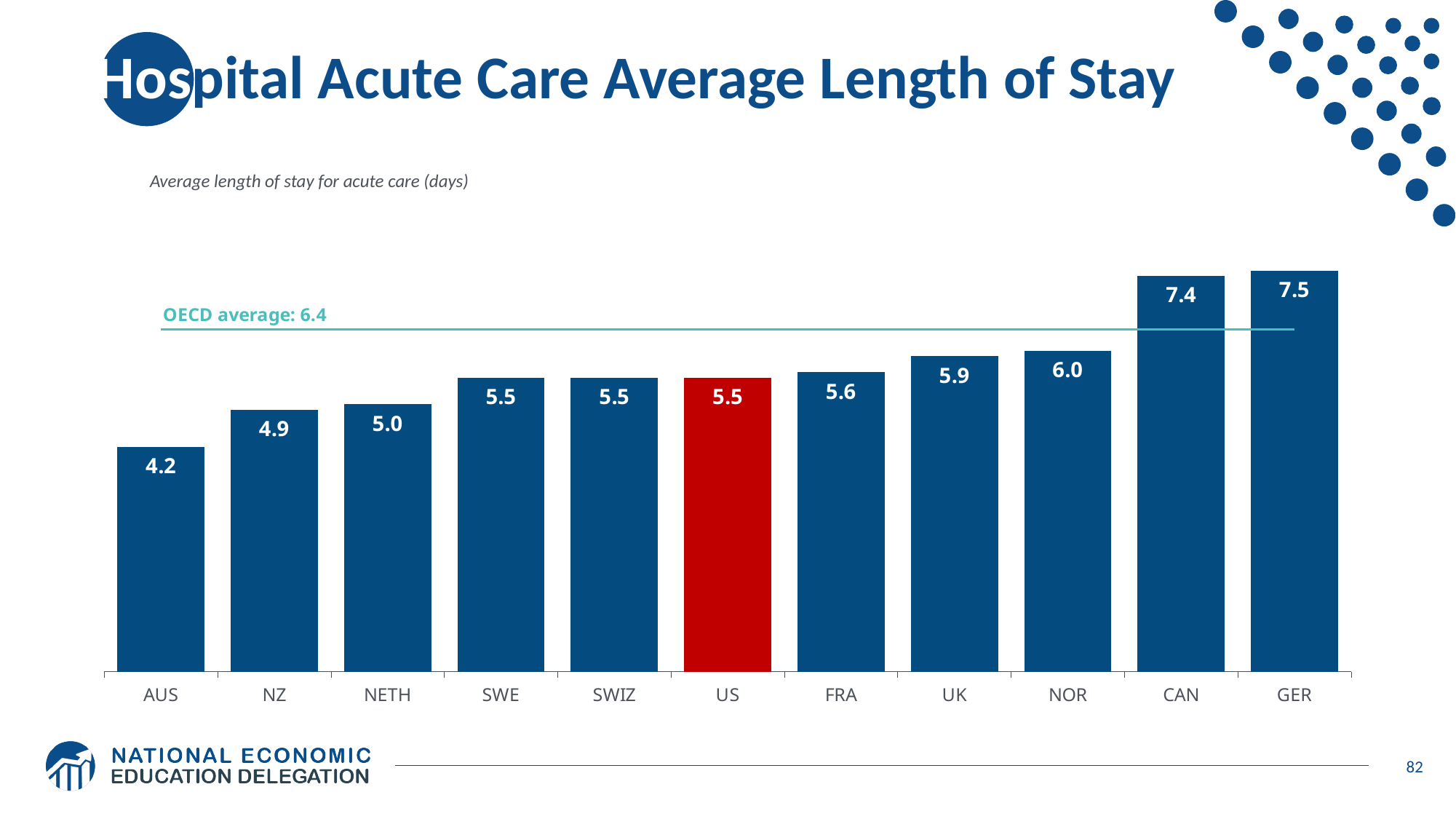
What type of chart is shown on the slide? Bar chart What is the average length of stay for acute care in the US? 5.5 What is the average length of stay for acute care in NOR? 6.0 What is the average length of stay for acute care in AUS? 4.2 How many countries are shown in the chart? 11 Which has a longer average length of stay, UK or NETH? UK Which country has the lowest average length of stay for acute care? AUS What is the OECD average shown on the chart? 6.4 Which country's bar is highlighted in red? US What is the difference in average length of stay between GER and AUS? 3.3 Which country has the highest average length of stay for acute care? GER What is the difference in average length of stay between CAN and the US? 1.9